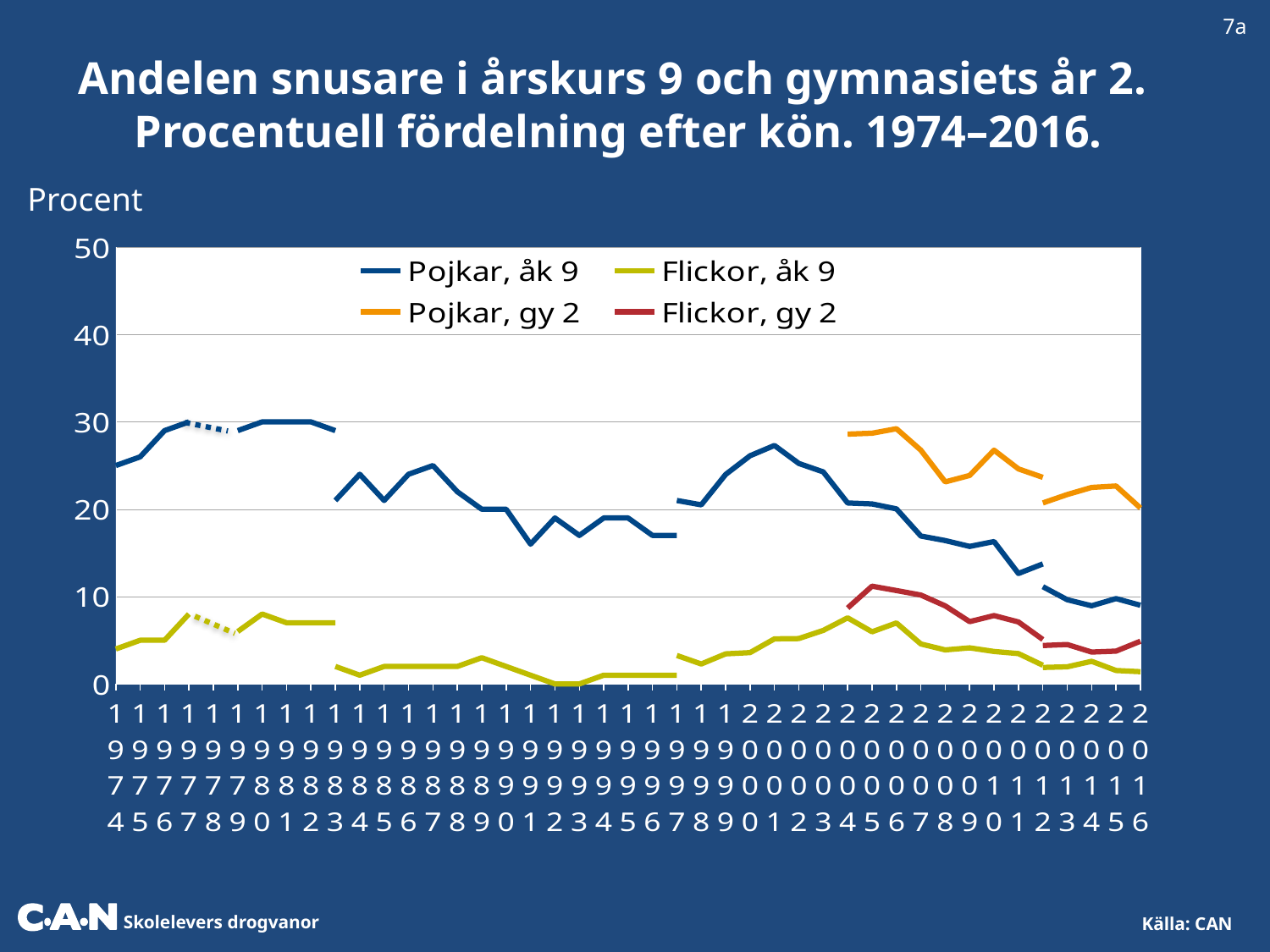
What are the four series named in the legend? Pojkar, åk 9; Pojkar, gy 2; Flickor, åk 9; Flickor, gy 2 Is the value for Pojkar, åk 9 in 1974 greater or less than 20? greater In 2010, which series has the higher value: Pojkar, gy 2 or Flickor, gy 2? Pojkar, gy 2 What is the label shown above the vertical axis? Procent Is the value for Flickor, gy 2 in 2016 greater or less than 10? less Which series has the lowest value in 1974? Flickor, åk 9 Is the value for Pojkar, gy 2 in 2004 greater or less than 20? greater Does the Pojkar, åk 9 series generally rise or fall between 2002 and 2016? Fall How many series does the legend list? 4 What kind of chart is shown on the slide? Line chart In 1974, which series has the higher value: Pojkar, åk 9 or Flickor, åk 9? Pojkar, åk 9